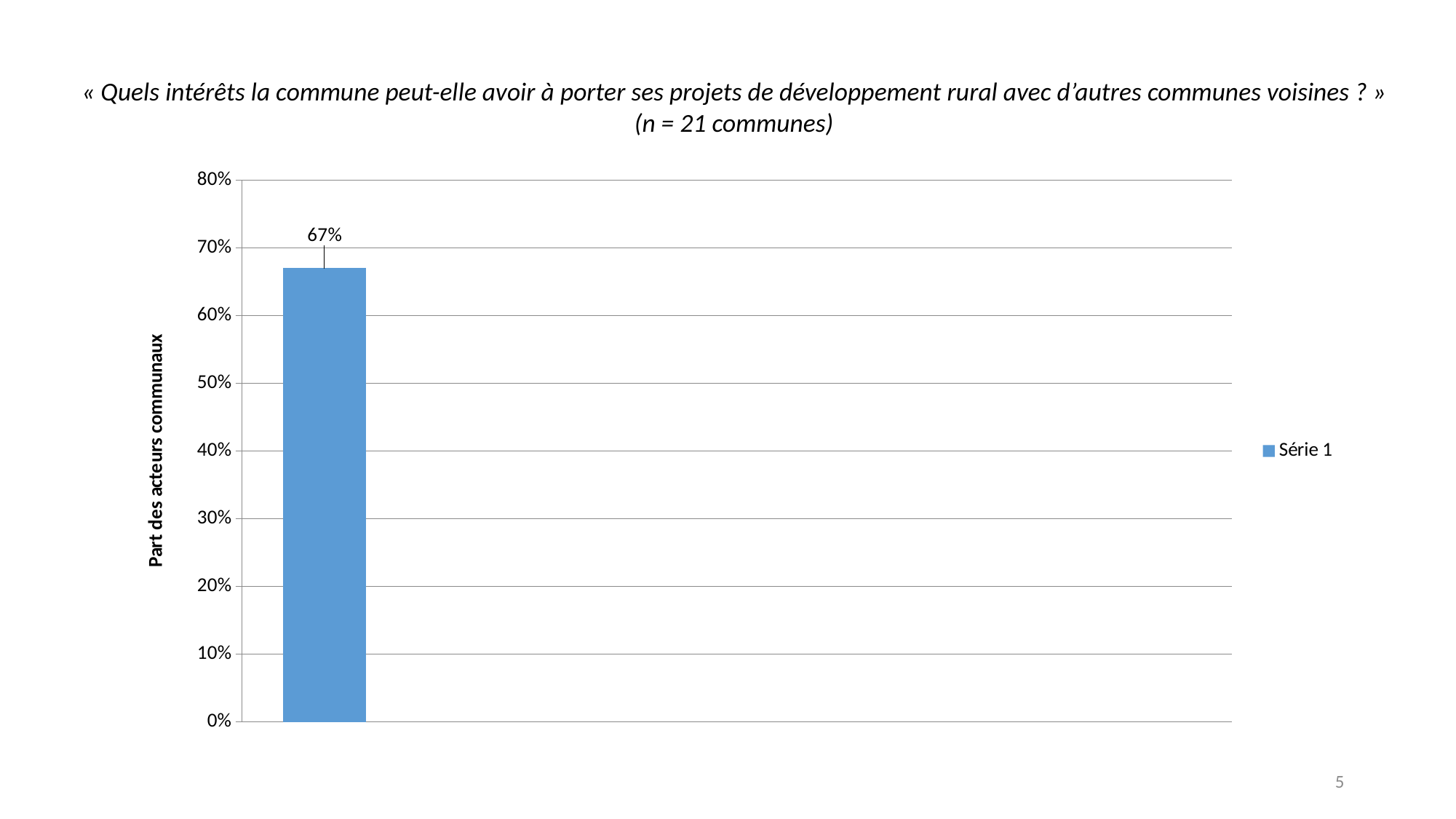
What is the highest value shown on the vertical axis? 80% How many bars are plotted in the chart? 1 What is the title of the vertical axis? Part des acteurs communaux Is the value of the bar greater or less than 60%? greater What is the name of the series shown in the legend? Série 1 Is the value of the bar greater or less than 70%? less What kind of chart is shown on the slide? bar chart How many series does the legend list? 1 What value is printed on the bar in the chart? 67% What is the value of the Série 1 bar? 67%